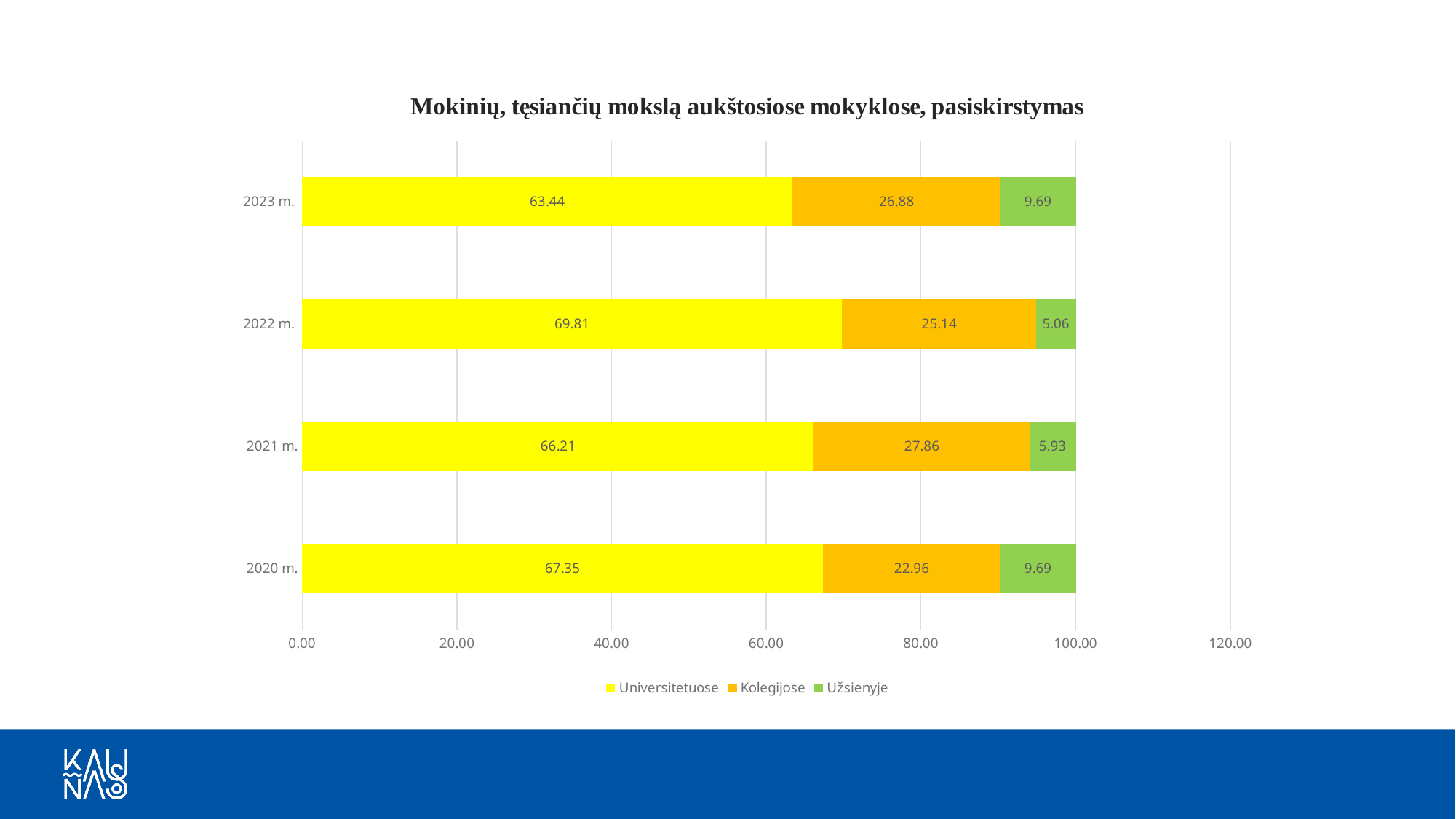
In which year is the Užsienyje value lowest? 2022 m. How many years are shown on the chart? 4 What is the value for Universitetuose in 2023 m.? 63.44 What is the difference between the Universitetuose values for 2022 m. and 2023 m.? 6.37 Which colour represents Kolegijose in the legend? Orange What kind of chart is shown on the slide? Stacked bar chart What is the value for Kolegijose in 2021 m.? 27.86 How many series does the legend list? 3 Which year has the larger Kolegijose value, 2023 m. or 2022 m.? 2023 m. In which year is the Universitetuose value highest? 2022 m. What is the total of the stacked bar for 2021 m.? 100.00 What is the value for Užsienyje in 2022 m.? 5.06